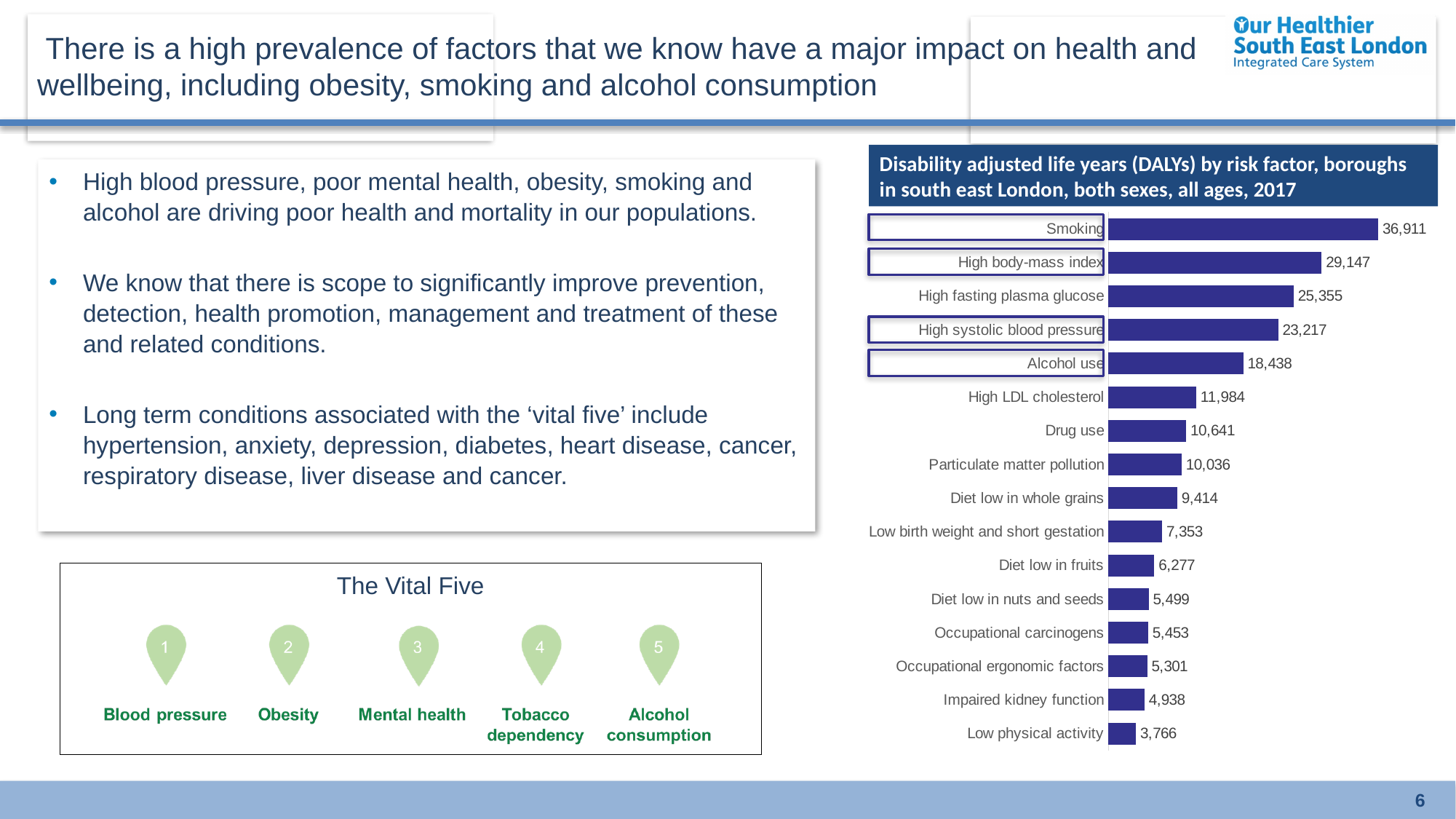
What type of chart is shown on the slide? Bar chart Which has a higher DALYs value, High fasting plasma glucose or High systolic blood pressure? High fasting plasma glucose Which risk factor has the lowest DALYs value? Low physical activity What is the difference in DALYs between Smoking and High body-mass index? 7,764 What is the DALYs value for Smoking? 36,911 How many risk factors are shown in the chart? 16 What is the DALYs value for Particulate matter pollution? 10,036 What is the DALYs value for Alcohol use? 18,438 What is the title of the chart? Disability adjusted life years (DALYs) by risk factor, boroughs in south east London, both sexes, all ages, 2017 Which has a higher DALYs value, Drug use or Diet low in whole grains? Drug use Which risk factor has the highest DALYs value? Smoking What is the difference in DALYs between Alcohol use and High LDL cholesterol? 6,454